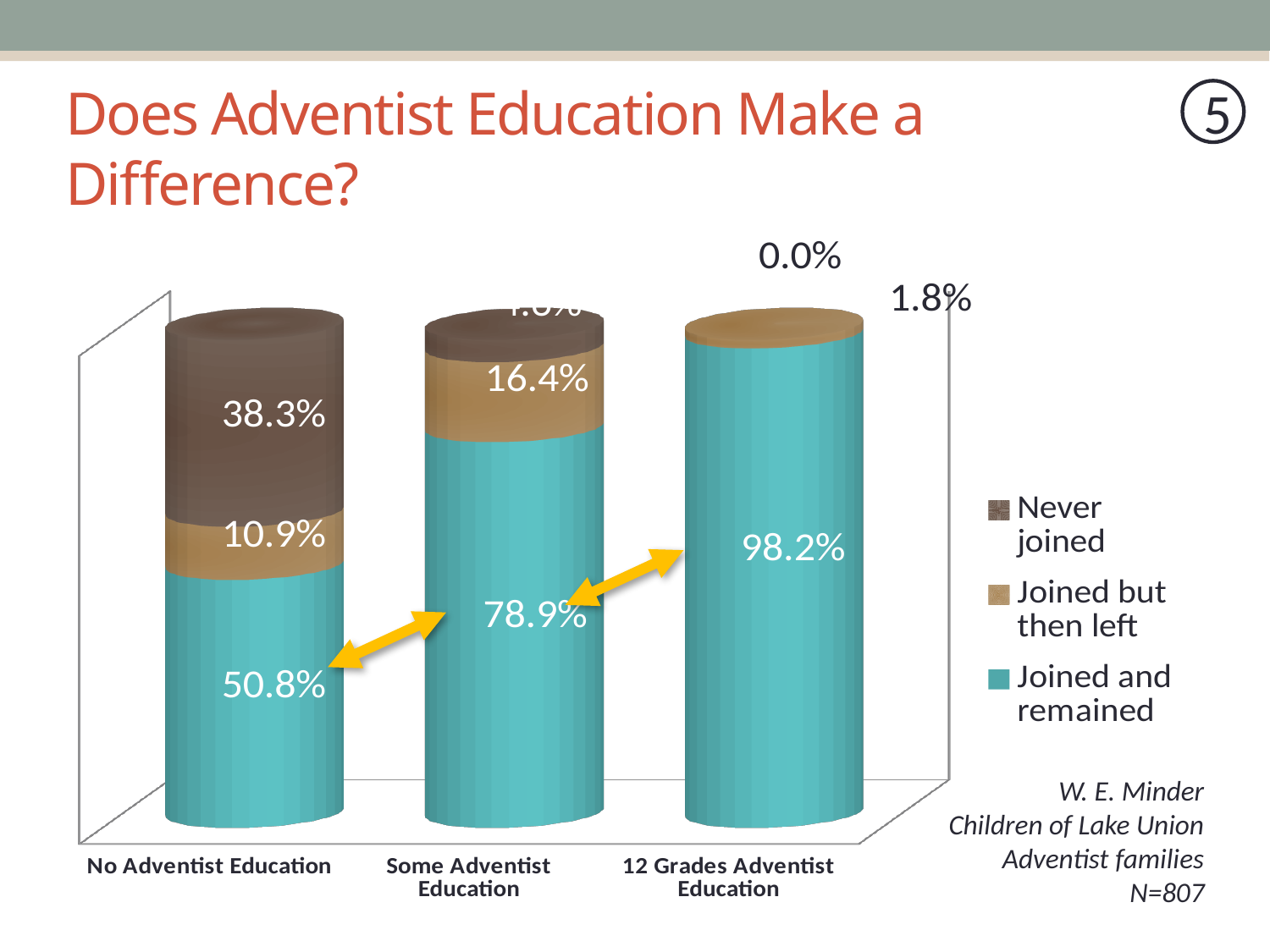
What is the 'Never joined' value for the No Adventist Education category? 38.3% What percentage of those with No Adventist Education joined and remained? 50.8% Does the 'Joined and remained' value rise or fall from No Adventist Education to 12 Grades Adventist Education? Rise How many education categories are shown on the x axis? 3 Which category has the highest 'Joined and remained' value? 12 Grades Adventist Education What percentage of those with 12 Grades Adventist Education joined and remained? 98.2% Which category has the lowest 'Joined and remained' value? No Adventist Education What is the 'Joined but then left' value for Some Adventist Education? 16.4% For No Adventist Education, which is larger: 'Never joined' or 'Joined but then left'? Never joined What is the difference in 'Joined and remained' between 12 Grades Adventist Education and No Adventist Education? 47.4 percentage points What is the 'Never joined' value for 12 Grades Adventist Education? 0.0% How many series does the legend list? 3